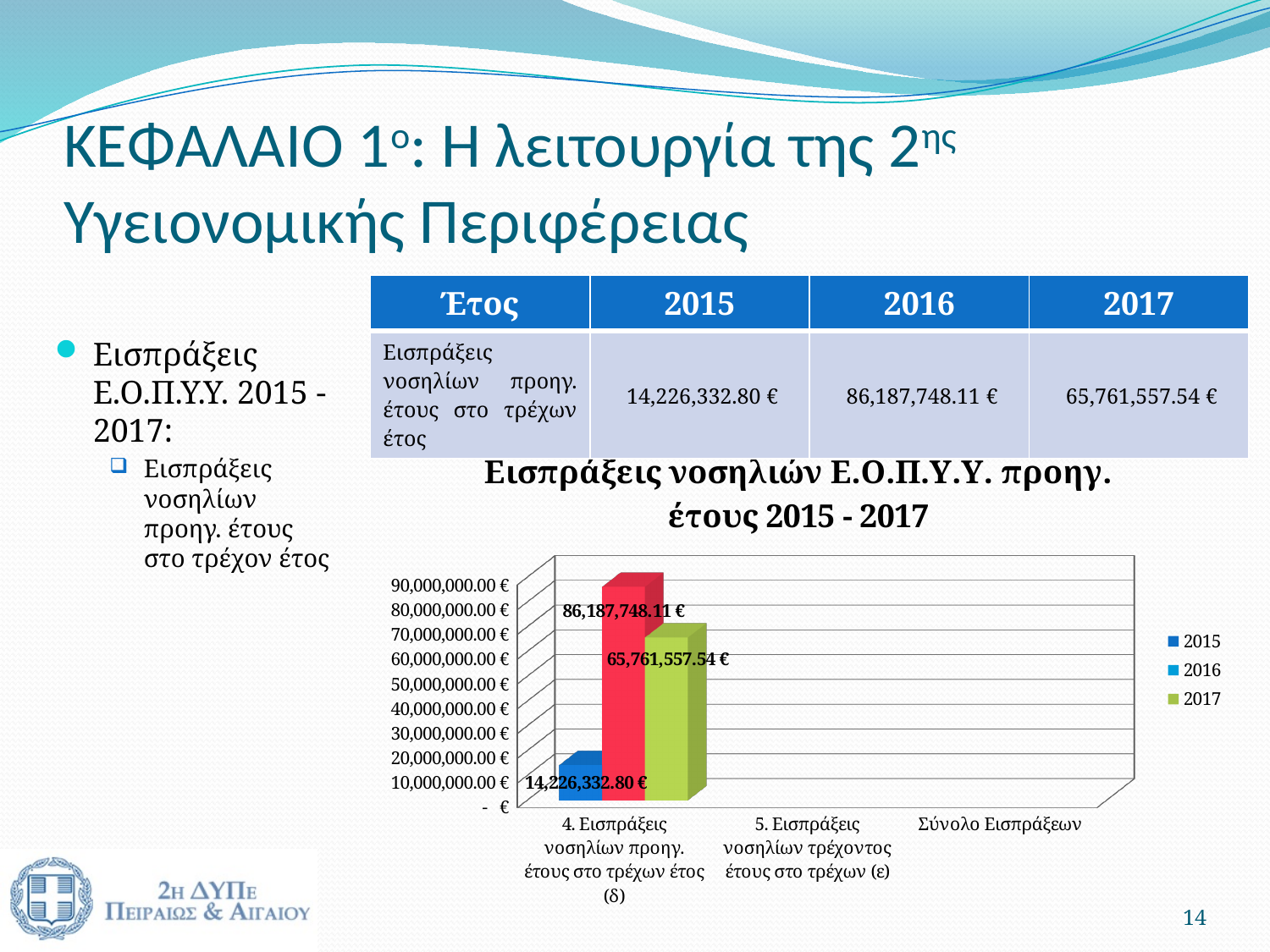
What is the value for 2016 in the chart? 86,187,748.11 € How many series does the legend list? 3 Which year has the lowest value in the chart? 2015 What is the difference between the 2016 and 2017 values? 20,426,190.57 € What is the value for 2015 in the chart? 14,226,332.80 € What is the value for 2017 in the chart? 65,761,557.54 € Is the value for 2017 greater or less than 60,000,000.00 €? greater What is the title of the chart? Εισπράξεις νοσηλιών Ε.Ο.Π.Υ.Υ. προηγ. έτους 2015 - 2017 Which is larger, the value for 2017 or the value for 2015? 2017 What is the difference between the 2016 and 2015 values? 71,961,415.31 € Which year has the highest value in the chart? 2016 What kind of chart is shown on the slide? Bar chart